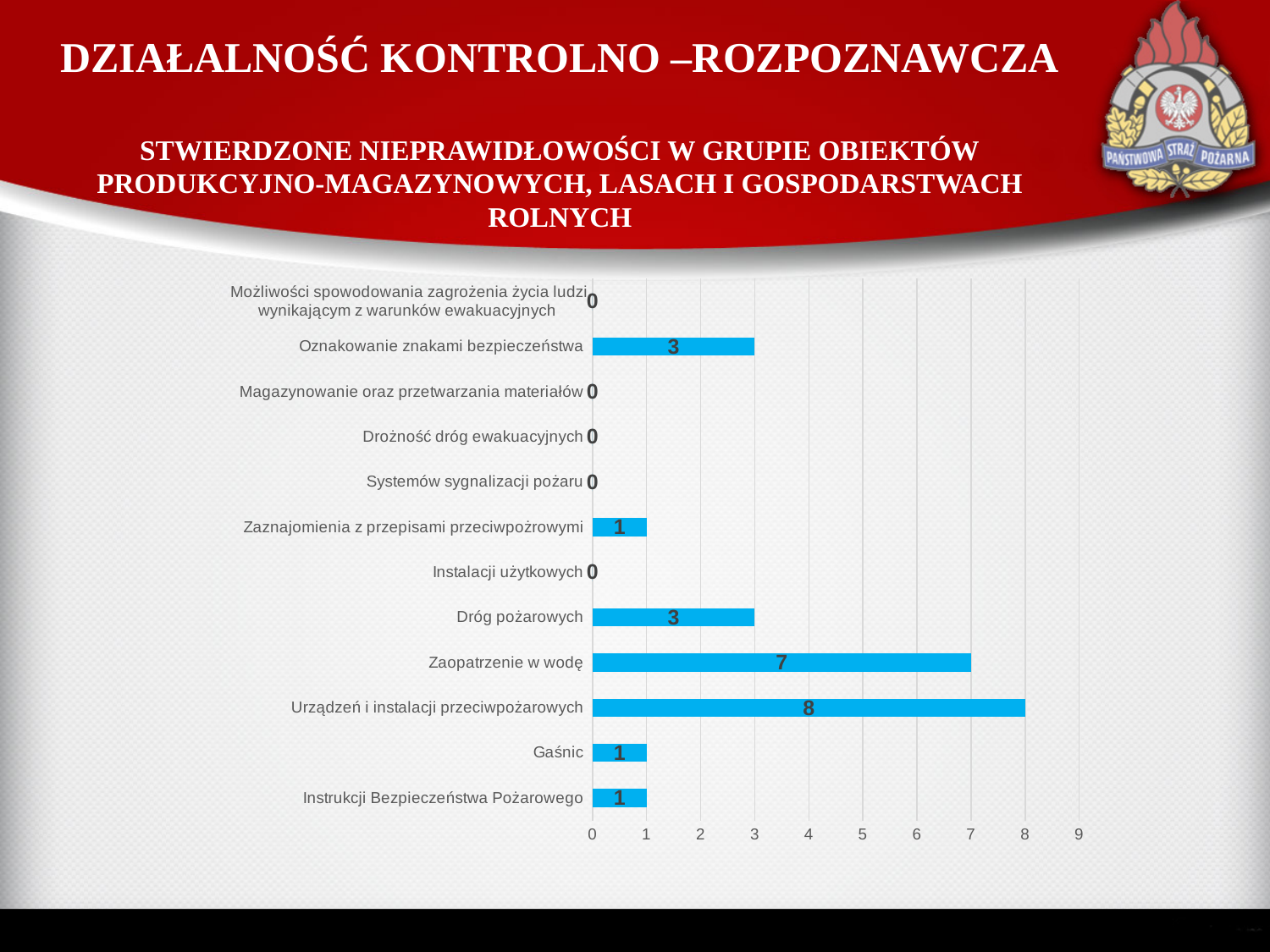
Which is larger, the value for Dróg pożarowych or the value for Zaznajomienia z przepisami przeciwpożrowymi? Dróg pożarowych What is the value for Systemów sygnalizacji pożaru? 0 What is the value for Zaopatrzenie w wodę? 7 How many categories have a value of 0? 5 Which category has the highest value? Urządzeń i instalacji przeciwpożarowych How many categories are shown on the chart? 12 What is the difference between the values for Zaopatrzenie w wodę and Dróg pożarowych? 4 What kind of chart is shown on the slide? Bar chart What is the value for Gaśnic? 1 What is the value for Urządzeń i instalacji przeciwpożarowych? 8 What is the difference between the values for Urządzeń i instalacji przeciwpożarowych and Zaopatrzenie w wodę? 1 What is the value for Oznakowanie znakami bezpieczeństwa? 3